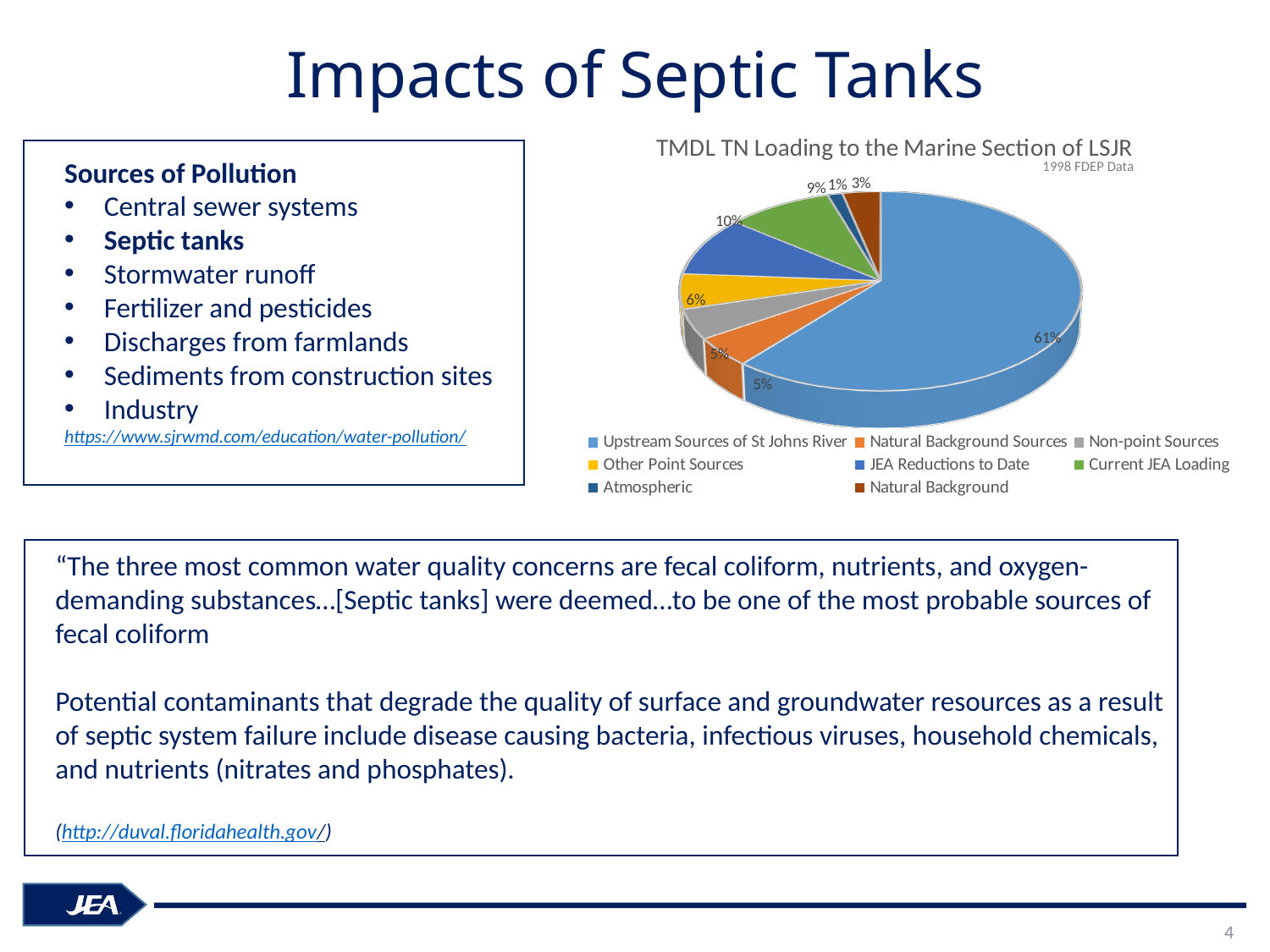
What is the title of the chart? TMDL TN Loading to the Marine Section of LSJR What percentage is shown for Other Point Sources? 6% What share of the pie is Upstream Sources of St Johns River? 61% What is the difference in percentage points between Upstream Sources of St Johns River and JEA Reductions to Date? 51 percentage points What percentage is shown for Natural Background? 3% Which is larger, JEA Reductions to Date or Current JEA Loading? JEA Reductions to Date What kind of chart is shown on the slide? Pie chart Which category has the smallest share of the pie? Atmospheric What percentage is shown for JEA Reductions to Date? 10% What percentage is shown for Current JEA Loading? 9% Which category has the largest share of the pie? Upstream Sources of St Johns River How many slices does the pie chart have? 8